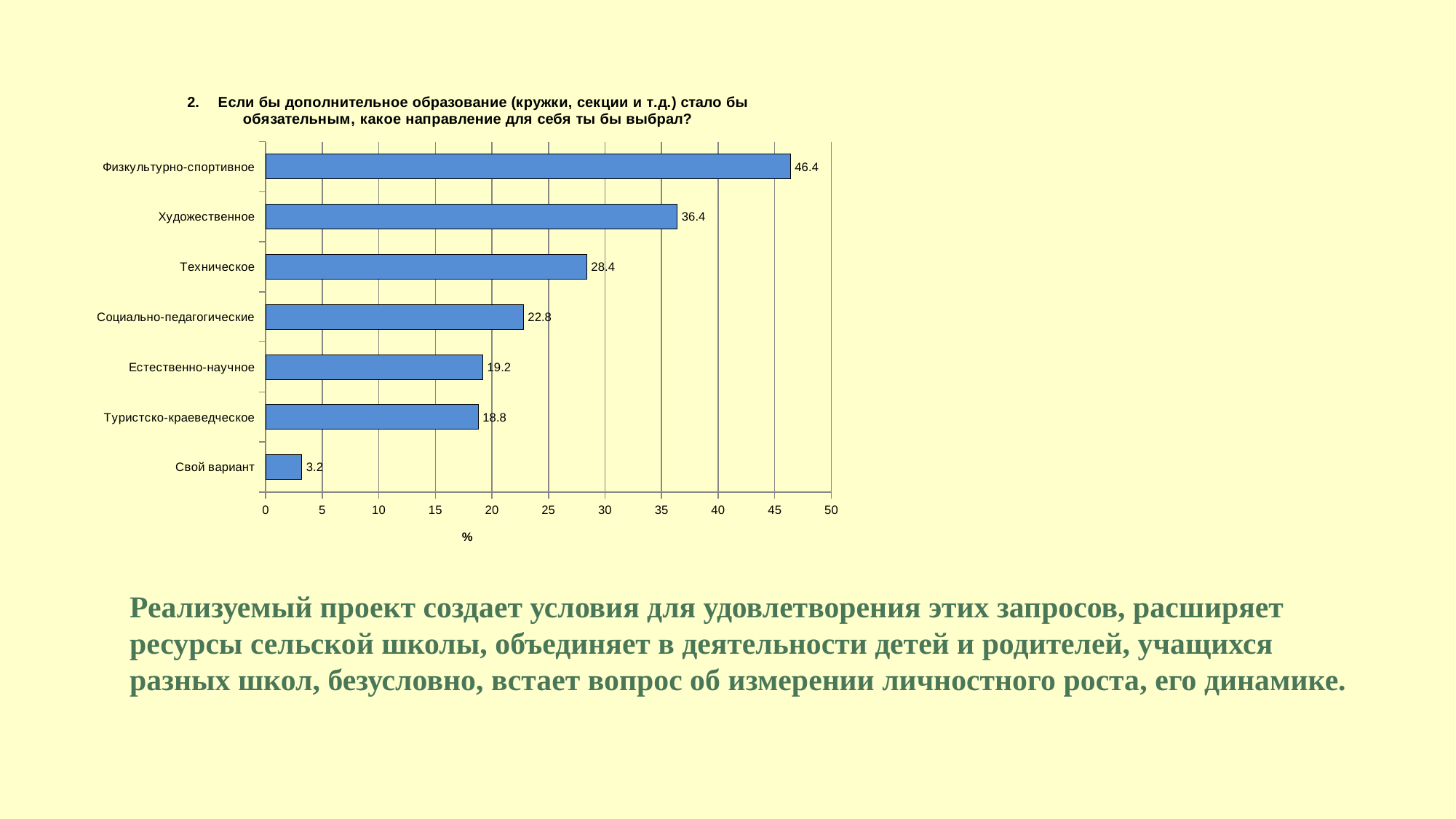
Is the value for Социально-педагогические greater or less than 20? greater What is the difference between the values for Техническое and Социально-педагогические? 5.6 What is the value for Физкультурно-спортивное? 46.4 What is the value for Художественное? 36.4 Which category has the highest value? Физкультурно-спортивное Which category has the lowest value? Свой вариант Which is larger, the value for Техническое or the value for Естественно-научное? Техническое What kind of chart is shown on the slide? bar chart What is the value for Свой вариант? 3.2 How many categories are shown in the chart? 7 What is the difference between the values for Физкультурно-спортивное and Художественное? 10 What is the value for Туристско-краеведческое? 18.8